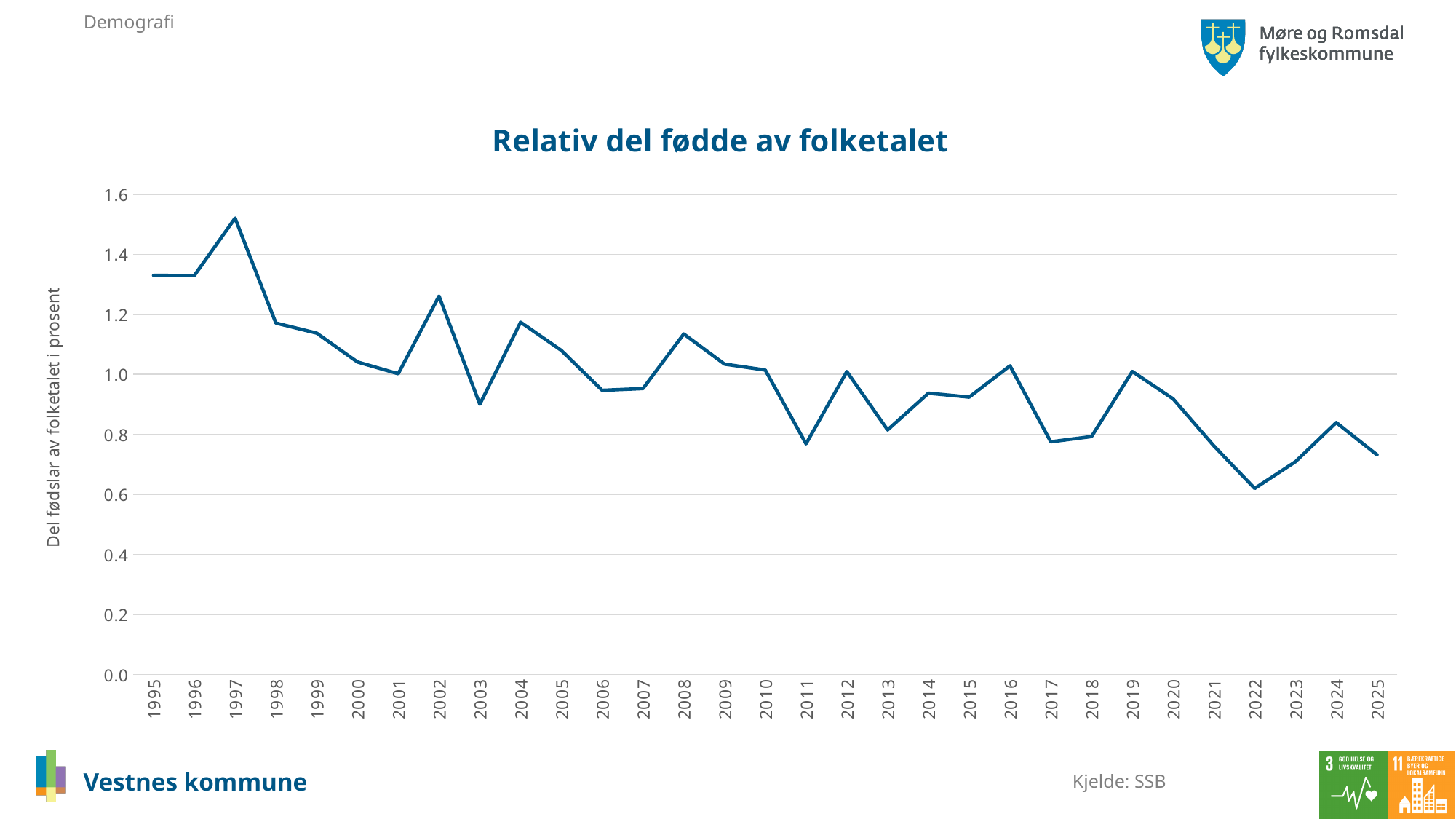
Is the value for 2002 greater or less than 1.2? greater What is the title of the chart? Relativ del fødde av folketalet What is the label on the vertical axis of the chart? Del fødslar av folketalet i prosent What kind of chart is shown on the slide? line chart Which year has the lowest value in the chart? 2022 Is the value for 1997 greater or less than 1.4? greater Which year has the larger value, 1995 or 2025? 1995 Which year has the larger value, 2002 or 2003? 2002 How many years are plotted along the x axis? 31 Is the value for 2022 greater or less than 0.8? less Which year has the highest value in the chart? 1997